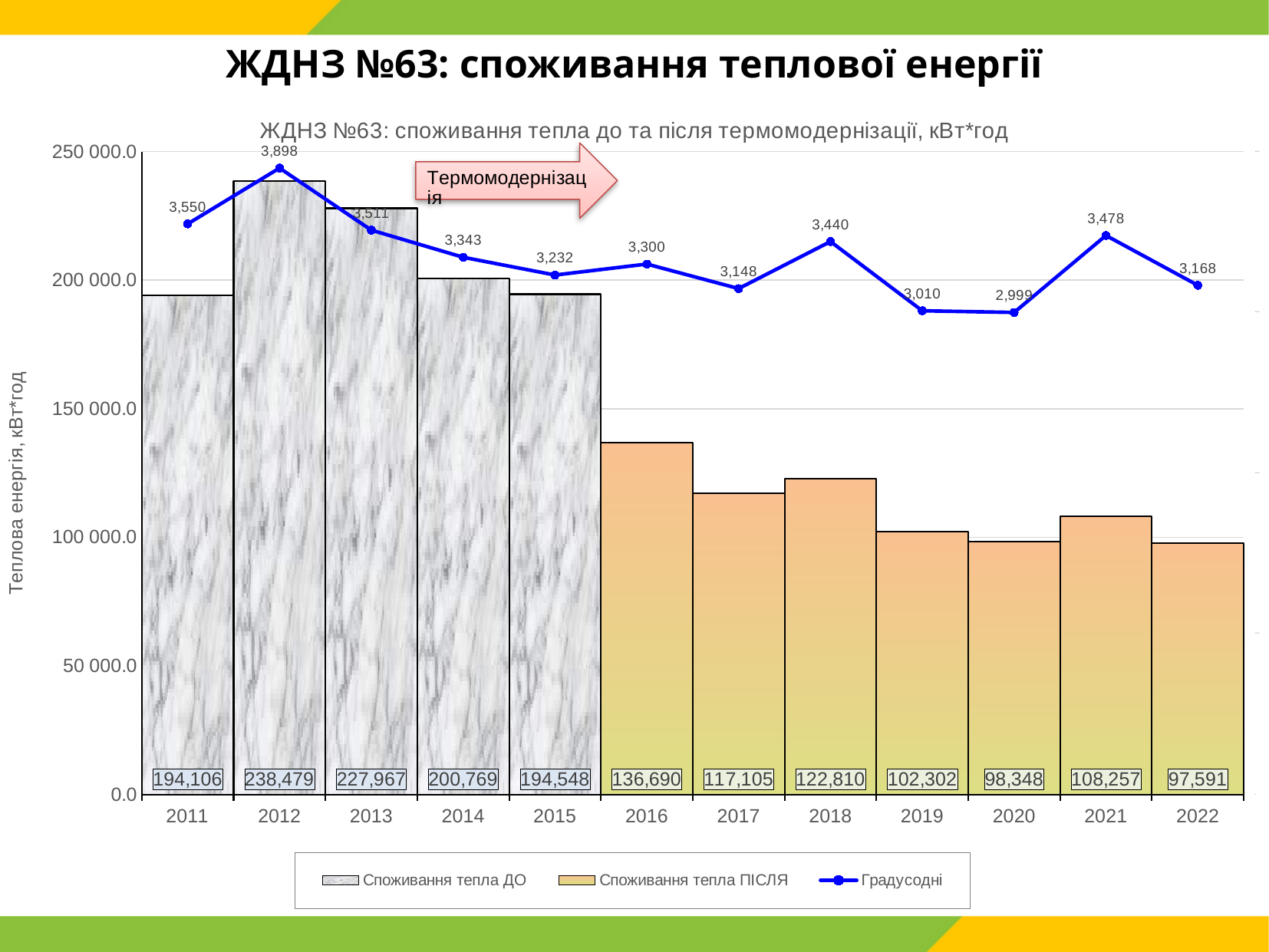
Which legend entry corresponds to the blue line? Градусодні Which is larger, the heat consumption in 2019 or in 2021? 2021 What is the difference between the heat consumption in 2015 and in 2016? 57,858 How many series does the legend list? 3 What is the heat consumption value shown for 2022? 97,591 How many years are shown on the x axis? 12 What kind of chart is shown on the slide? Combined bar and line chart What is the Градусодні (degree-days) value shown for 2018? 3,440 What is the heat consumption value shown for 2012? 238,479 Which year has the lowest Градусодні value on the line? 2020 Which year has the highest heat consumption bar? 2012 Which year has the lowest heat consumption bar? 2022